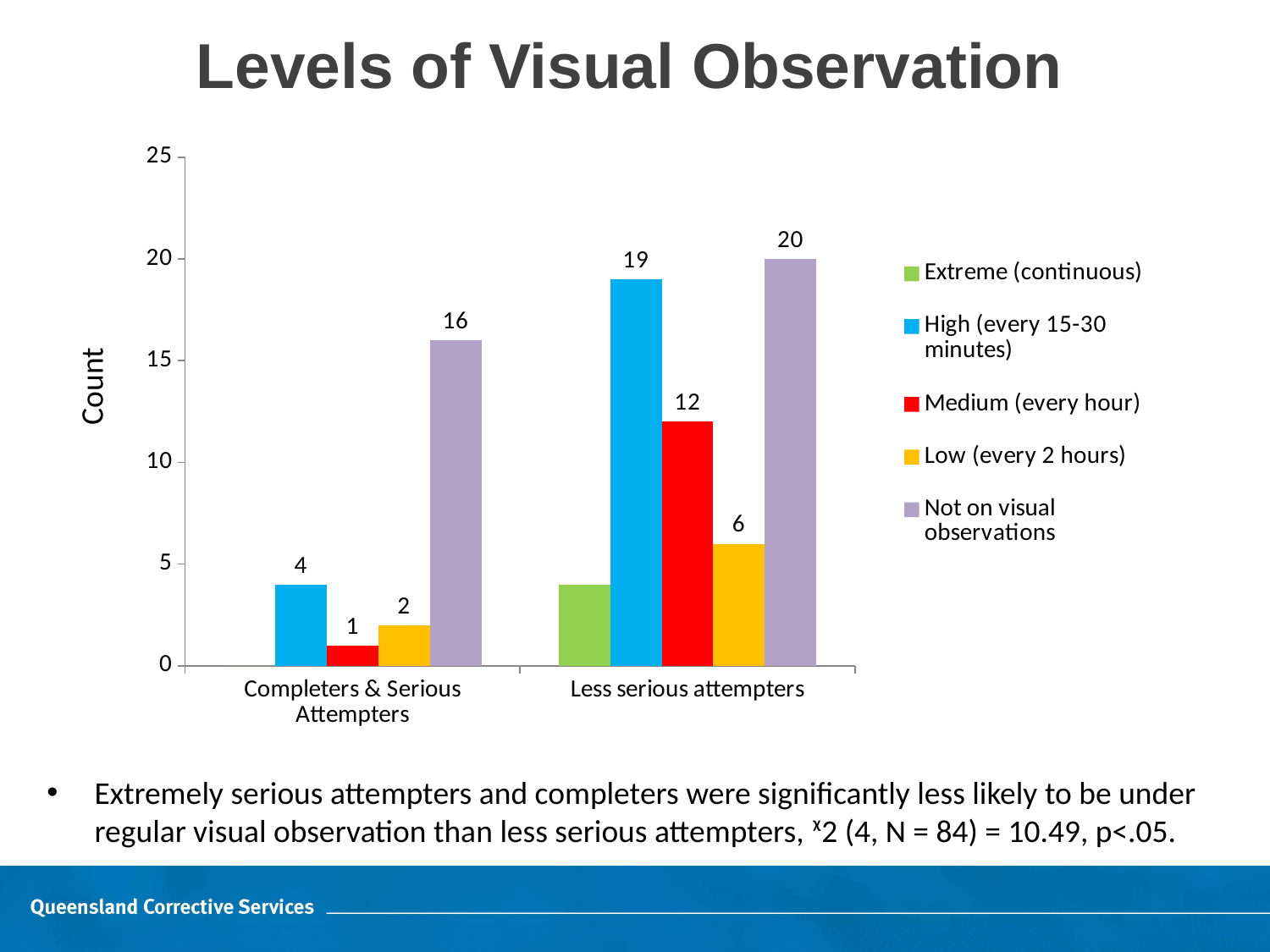
Which labelled observation level has the lowest count among Completers & Serious Attempters? Medium (every hour) What is the count for Medium (every hour) among Completers & Serious Attempters? 1 What is the count for Low (every 2 hours) among Less serious attempters? 6 Is the Extreme (continuous) count for Less serious attempters greater or less than 5? less What is the difference between the Not on visual observations counts for Less serious attempters and Completers & Serious Attempters? 4 Which observation level has the highest count among Less serious attempters? Not on visual observations What is the title of the chart? Levels of Visual Observation What is the count for High (every 15-30 minutes) among Less serious attempters? 19 How many series does the legend list? 5 What is the count for Not on visual observations among Completers & Serious Attempters? 16 Which is larger: the Medium (every hour) count for Less serious attempters or the Low (every 2 hours) count for Less serious attempters? Medium (every hour) for Less serious attempters What kind of chart is shown on the slide? Bar chart